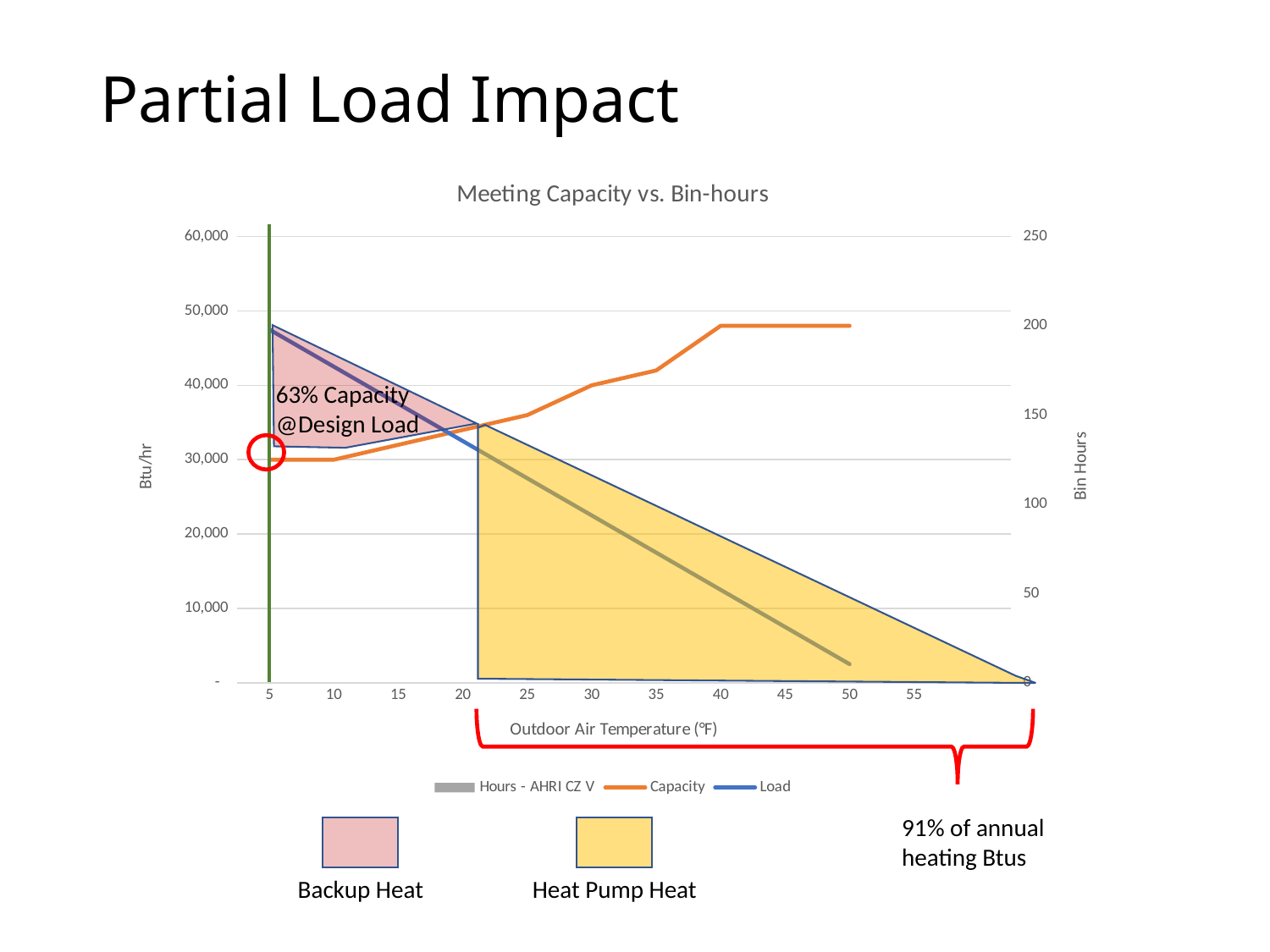
What kind of chart is shown on the slide? line chart At 5 °F, which is larger: the Capacity value or the Load value? Load What is the label of the x axis? Outdoor Air Temperature (°F) Does the Load series rise or fall as outdoor air temperature increases? fall Is the Load value at 5 °F greater or less than 40,000 Btu/hr? greater Does the Capacity series rise or fall as outdoor air temperature increases? rise Is the Load value at 50 °F greater or less than 10,000 Btu/hr? less How many series does the chart legend list? 3 At 50 °F, which is larger: the Capacity value or the Load value? Capacity Is the Capacity value at 50 °F greater or less than 40,000 Btu/hr? greater What is the title of the chart? Meeting Capacity vs. Bin-hours